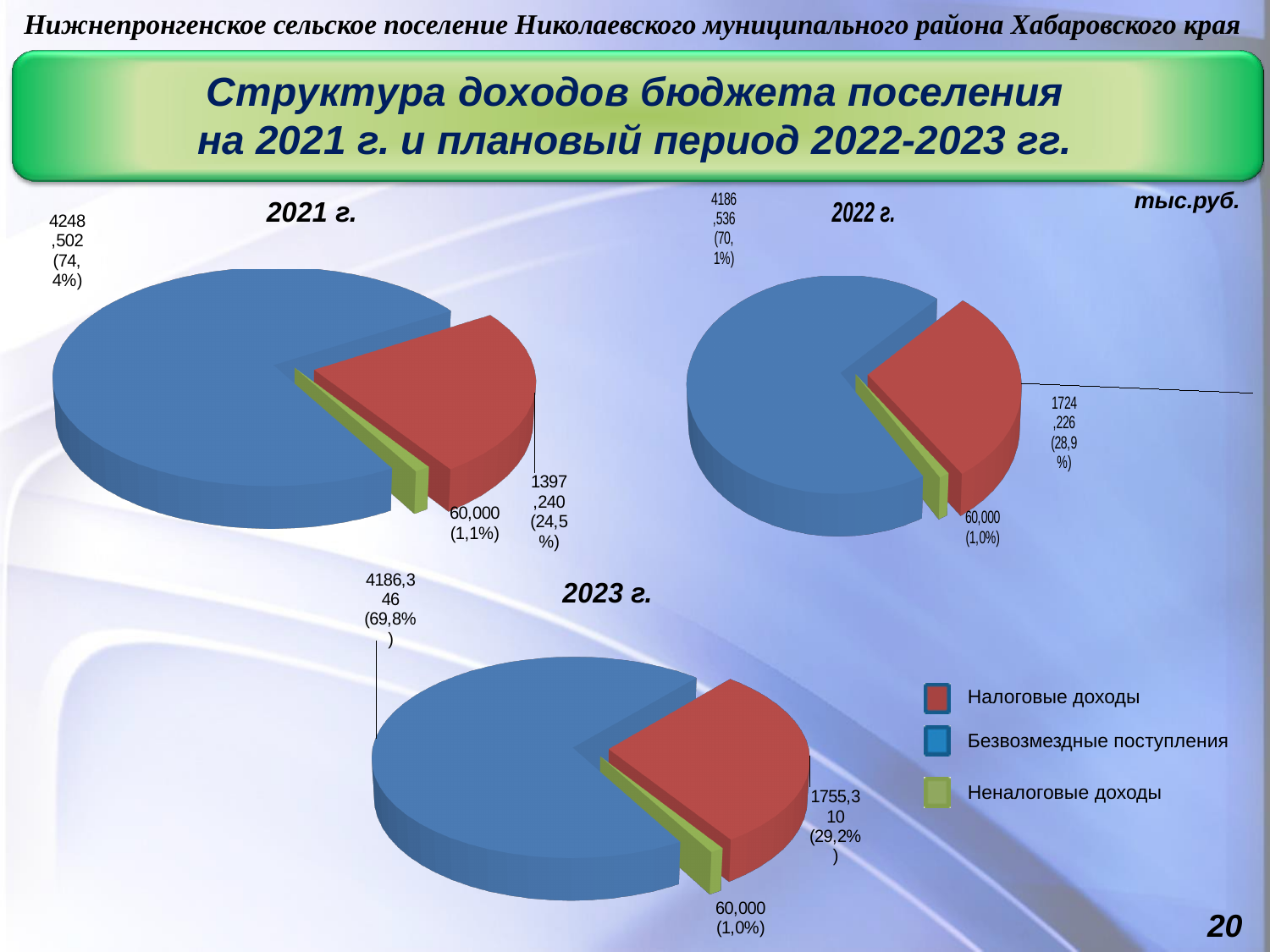
On the 2023 г. pie chart, which category has the largest slice? Безвозмездные поступления On the 2021 г. pie chart, what is the value for Безвозмездные поступления? 4248,502 On the 2022 г. pie chart, what is the value for Налоговые доходы? 1724,226 On the 2023 г. pie chart, what share of the pie is Неналоговые доходы? 1,0% How many slices does the 2021 г. pie chart have? 3 On the 2023 г. pie chart, what is the value for Налоговые доходы? 1755,310 On the 2022 г. pie chart, what share of the pie is Безвозмездные поступления? 70,1% What type of chart is used for 2022 г.? Pie chart On the 2021 г. pie chart, what share of the pie is Налоговые доходы? 24,5% On the 2022 г. pie chart, which category has the smallest slice? Неналоговые доходы On the 2021 г. pie chart, which is larger: Налоговые доходы or Неналоговые доходы? Налоговые доходы How many entries does the legend list? 3